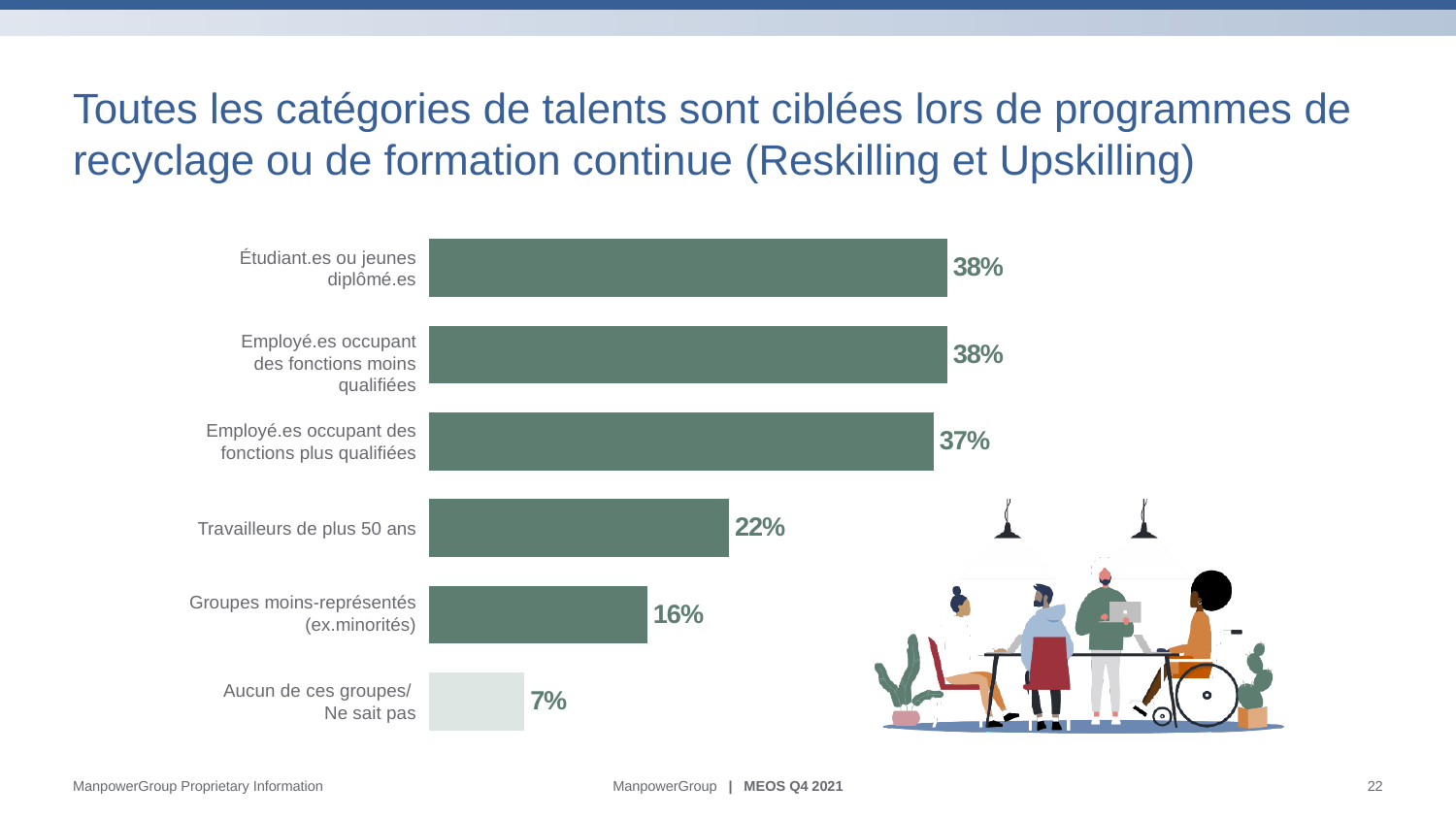
What is the value for "Groupes moins-représentés (ex.minorités)"? 16% What is the difference between the values for "Travailleurs de plus 50 ans" and "Groupes moins-représentés (ex.minorités)"? 6% What kind of chart is shown on the slide? Bar chart What is the value for "Étudiant.es ou jeunes diplômé.es"? 38% What is the value for "Travailleurs de plus 50 ans"? 22% What is the value for "Aucun de ces groupes/Ne sait pas"? 7% What is the difference between the values for "Étudiant.es ou jeunes diplômé.es" and "Aucun de ces groupes/Ne sait pas"? 31% Which bar is drawn in a lighter colour than the others? Aucun de ces groupes/Ne sait pas How many categories are shown in the chart? 6 Which category has the lowest value? Aucun de ces groupes/Ne sait pas What is the value for "Employé.es occupant des fonctions plus qualifiées"? 37% Which is larger, the value for "Employé.es occupant des fonctions plus qualifiées" or the value for "Travailleurs de plus 50 ans"? Employé.es occupant des fonctions plus qualifiées